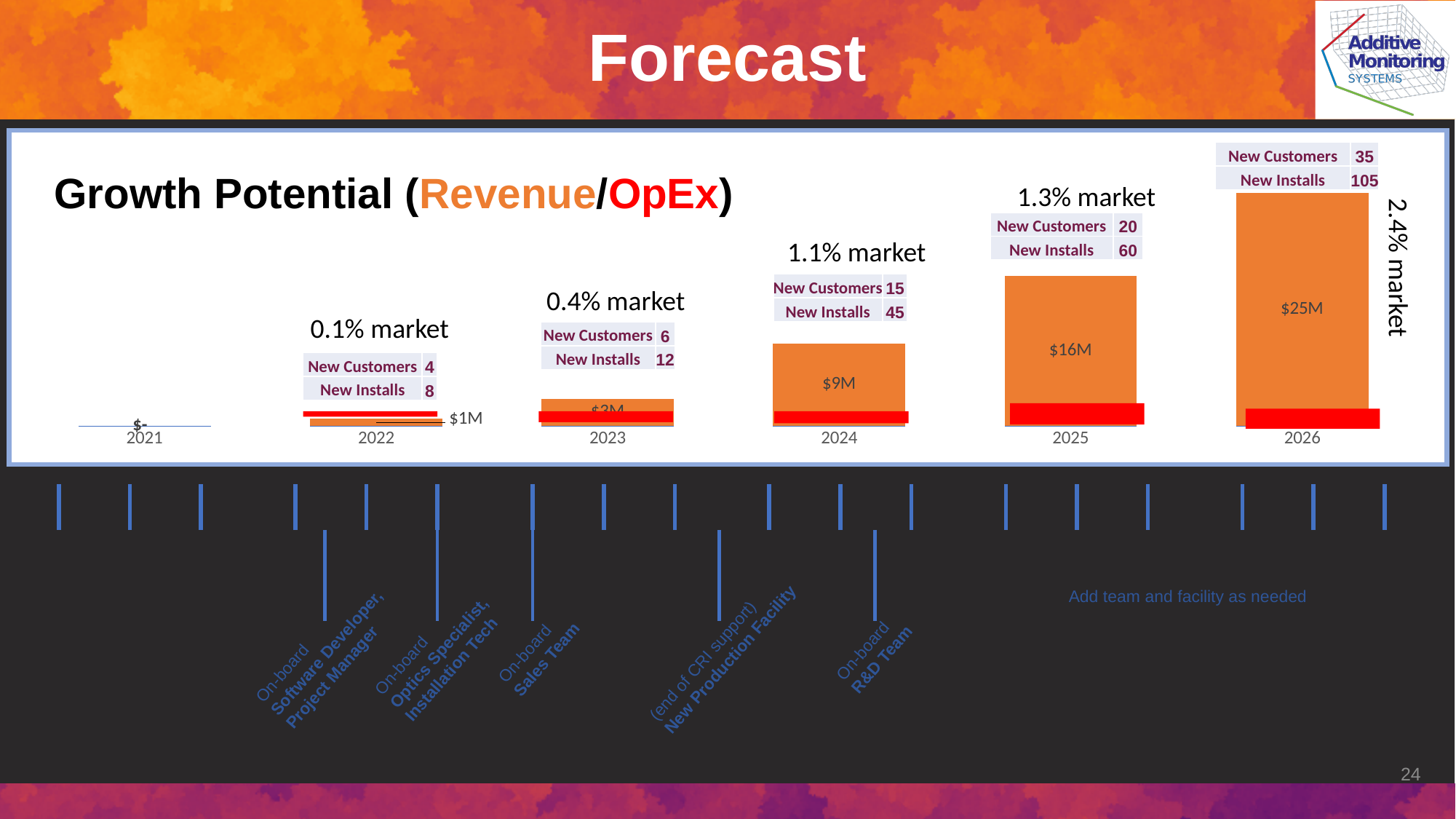
What is the difference between the revenue for 2026 and the revenue for 2025? $9M How many New Customers are listed for 2025? 20 How many New Installs are listed for 2026? 105 What is the revenue value shown for 2022 in the Growth Potential chart? $1M Which year has the highest revenue in the Growth Potential chart? 2026 What is the revenue value shown for 2024 in the Growth Potential chart? $9M Do the revenue values rise or fall from 2021 to 2026? rise Which year has the larger revenue, 2024 or 2025? 2025 How many years are shown on the x axis of the Growth Potential chart? 6 What kind of chart is the Growth Potential chart? bar chart What is the revenue value shown for 2026 in the Growth Potential chart? $25M What market share percentage is annotated above the 2024 bar? 1.1% market